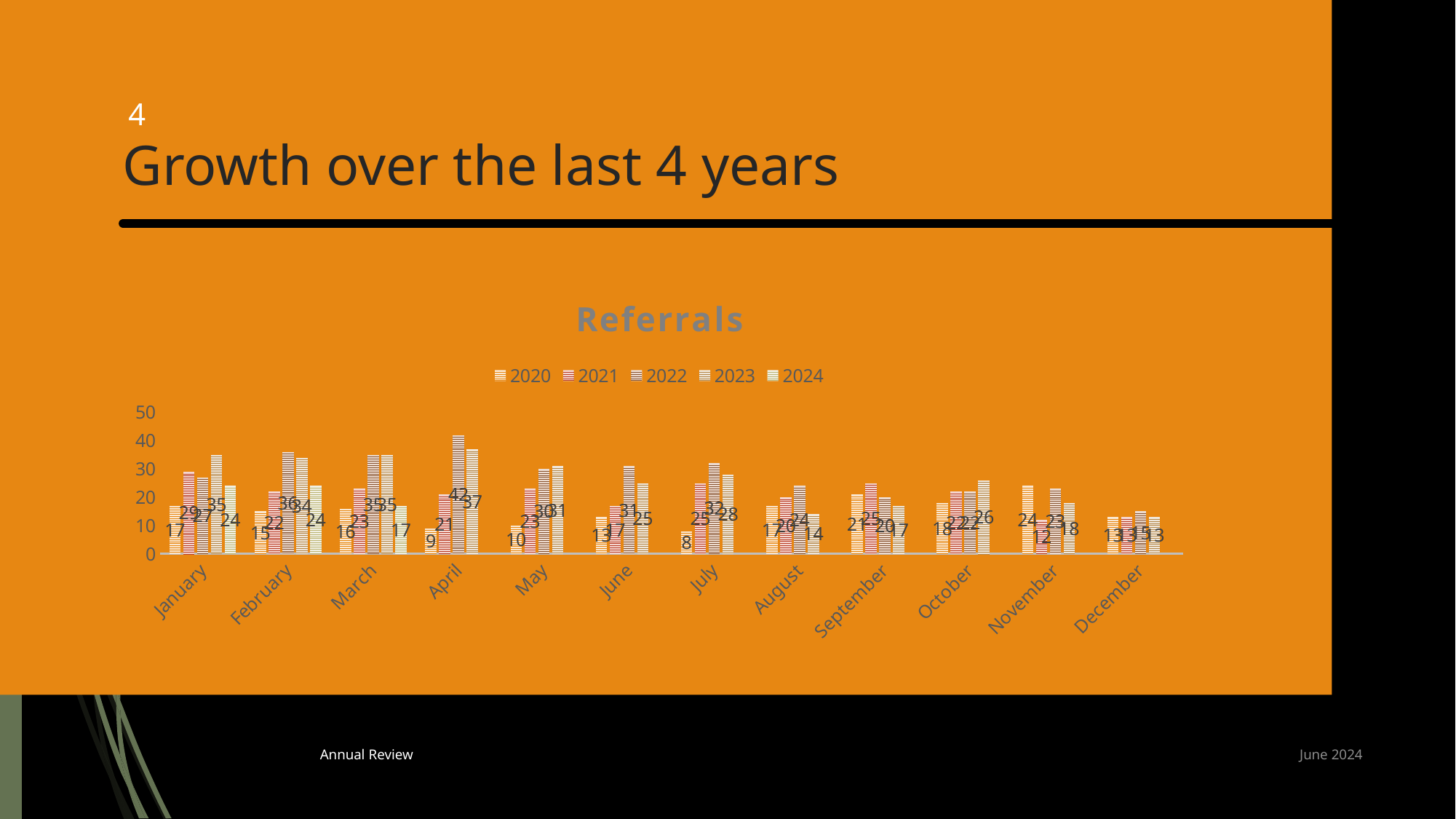
How many months are shown along the x axis? 12 What is the title of the chart? Referrals How many series does the legend list? 5 Which is larger in April, the value for 2022 or the value for 2023? 2022 What kind of chart is shown on the slide? bar chart What is the value for 2020 in July? 8 What is the value for 2020 in January? 17 Which month has the lowest value for 2020? July What is the value for 2022 in April? 42 What is the value for 2023 in January? 35 What is the difference between the 2023 and 2020 values in January? 18 Which month has the highest value for 2020? November